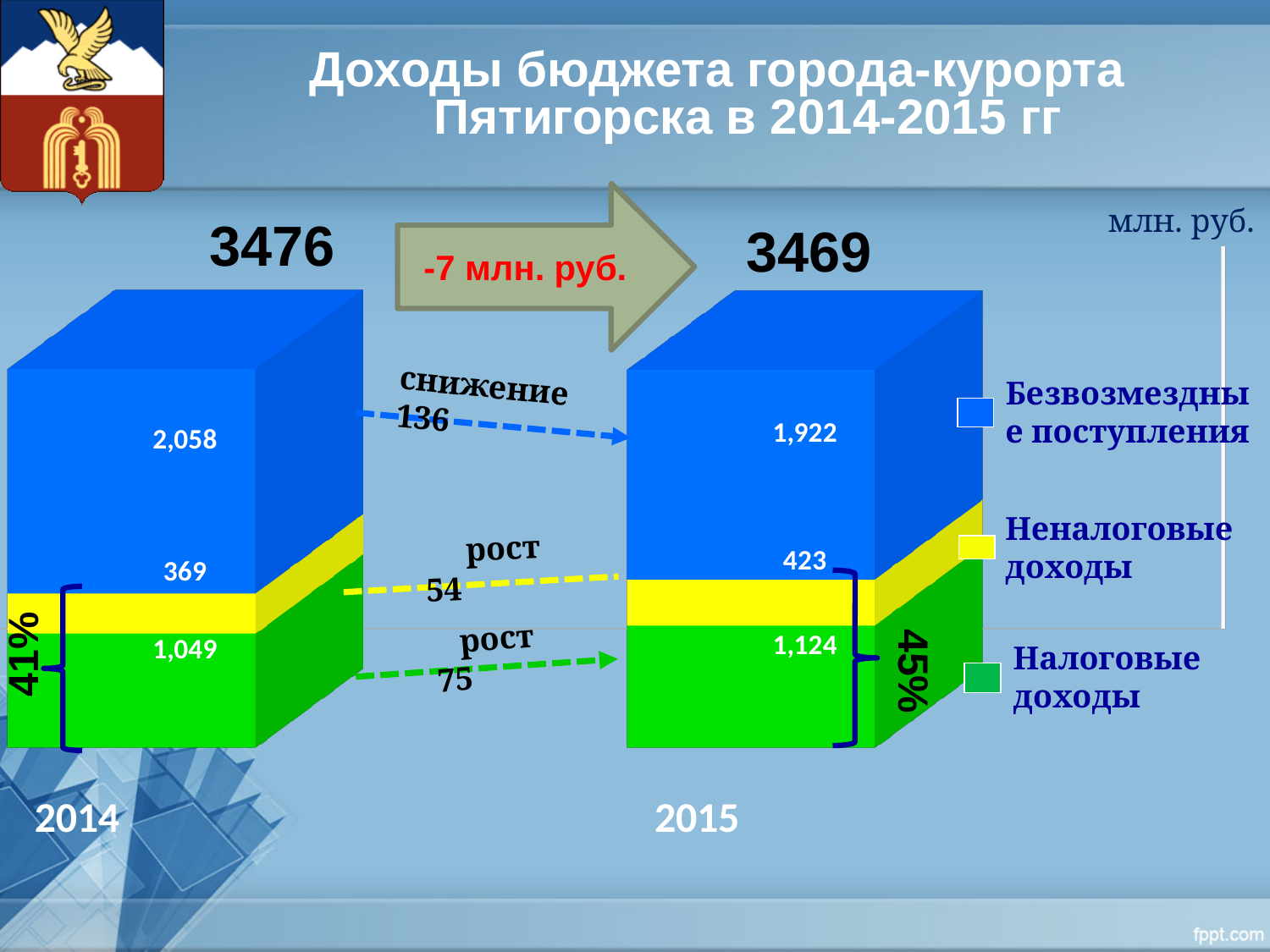
What is the difference in Неналоговые доходы between 2015 and 2014? 54 What share of the 2015 budget revenue do Налоговые доходы make up, according to the label on the slide? 45% Which series is the largest segment in the 2015 bar? Безвозмездные поступления What kind of chart is shown on the slide? Stacked bar chart What is the value of Налоговые доходы for 2015? 1,124 What is the total of the stacked bar for 2014? 3476 By how much did Безвозмездные поступления change from 2014 to 2015? снижение 136 How many series does the legend list? 3 What is the value of Безвозмездные поступления for 2014? 2,058 What is the value of Неналоговые доходы for 2014? 369 What is the total of the stacked bar for 2015? 3469 Which year has the larger value for Налоговые доходы, 2014 or 2015? 2015